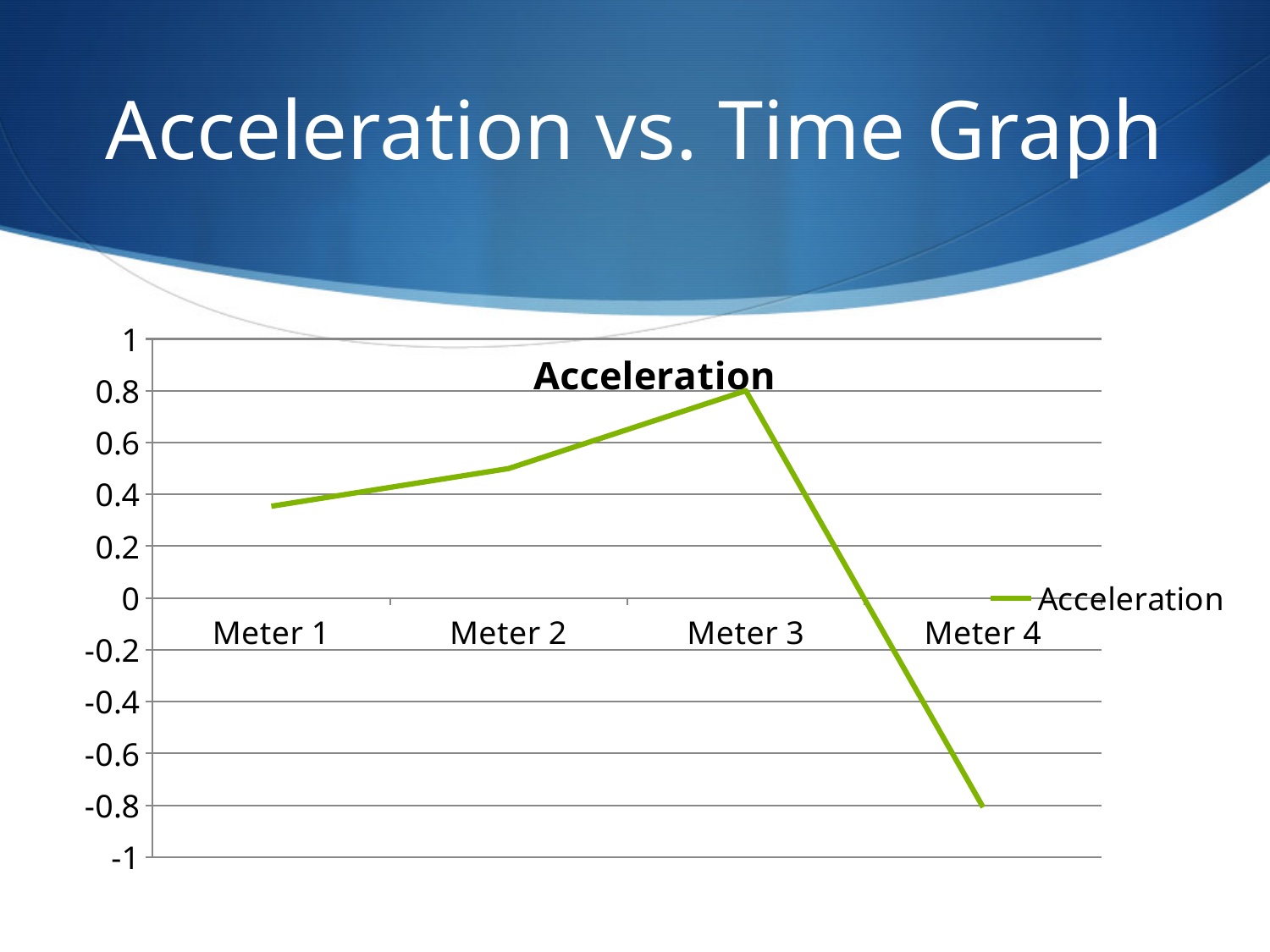
How does the acceleration change from Meter 1 to Meter 4? It rises from Meter 1 to Meter 3, then falls sharply at Meter 4 How many series does the legend list? 1 Which has the larger acceleration value, Meter 1 or Meter 2? Meter 2 Which meter has the lowest acceleration value? Meter 4 What is the title of the chart? Acceleration What type of chart is shown on the slide? Line chart How many categories are plotted along the x axis? 4 Which meter has the highest acceleration value? Meter 3 Is the acceleration value for Meter 2 greater or less than 0.4? greater What is the acceleration value for Meter 3? 0.8